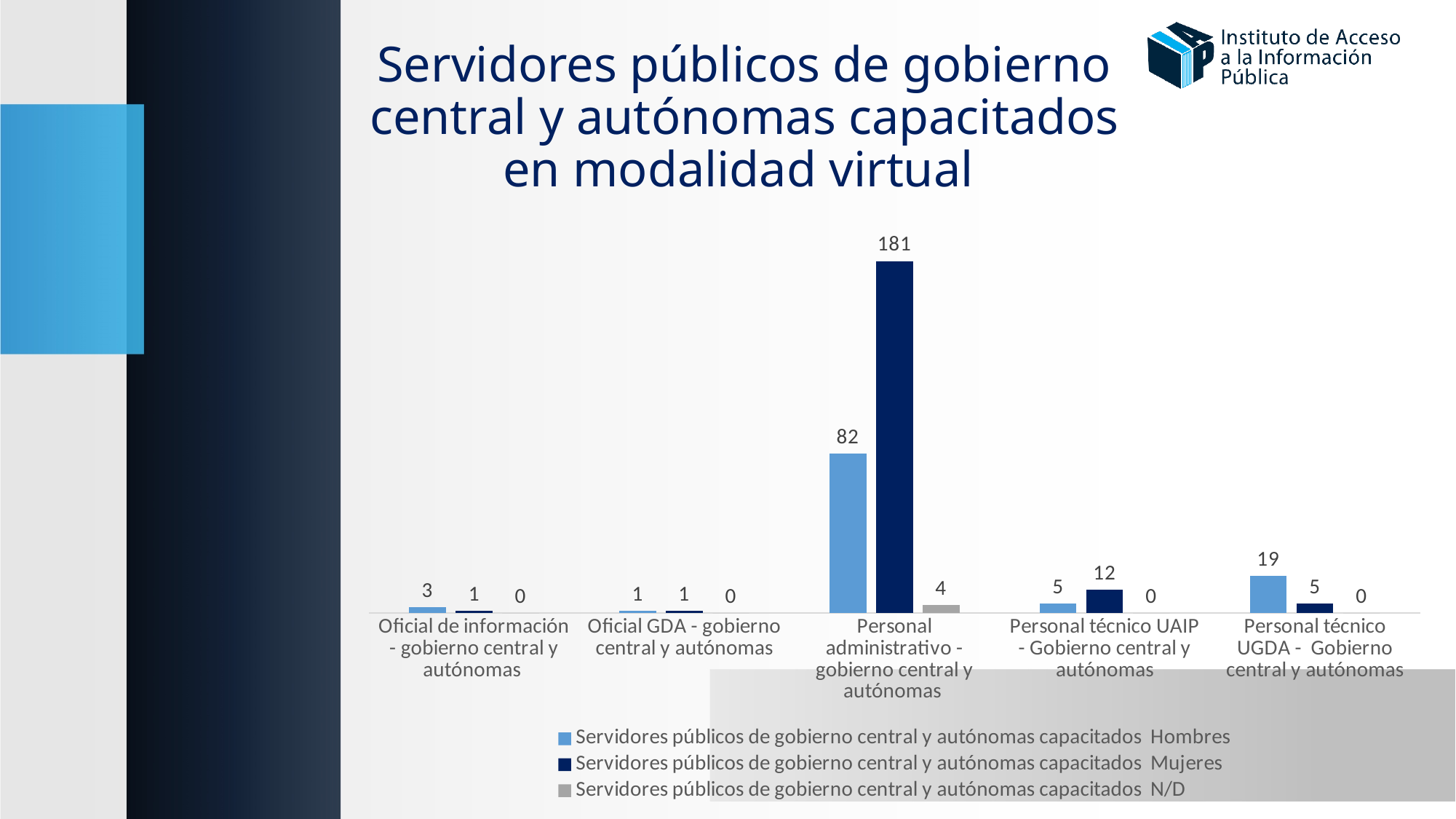
Which category has the highest value for Mujeres? Personal administrativo - gobierno central y autónomas What colour are the bars for the Mujeres series? dark navy blue What is the difference between the Mujeres and Hombres values in the category 'Personal administrativo - gobierno central y autónomas'? 99 What is the value for Mujeres in the category 'Personal técnico UAIP - Gobierno central y autónomas'? 12 What is the value for N/D in the category 'Personal administrativo - gobierno central y autónomas'? 4 How many series does the legend list? 3 What type of chart is shown on the slide? bar chart What is the value for Mujeres in the category 'Personal administrativo - gobierno central y autónomas'? 181 What is the total of the three series in the category 'Personal técnico UAIP - Gobierno central y autónomas'? 17 In the category 'Personal técnico UGDA - Gobierno central y autónomas', which is larger, the Hombres value or the Mujeres value? Hombres How many categories are shown on the x axis? 5 What is the value for Hombres in the category 'Personal técnico UGDA - Gobierno central y autónomas'? 19